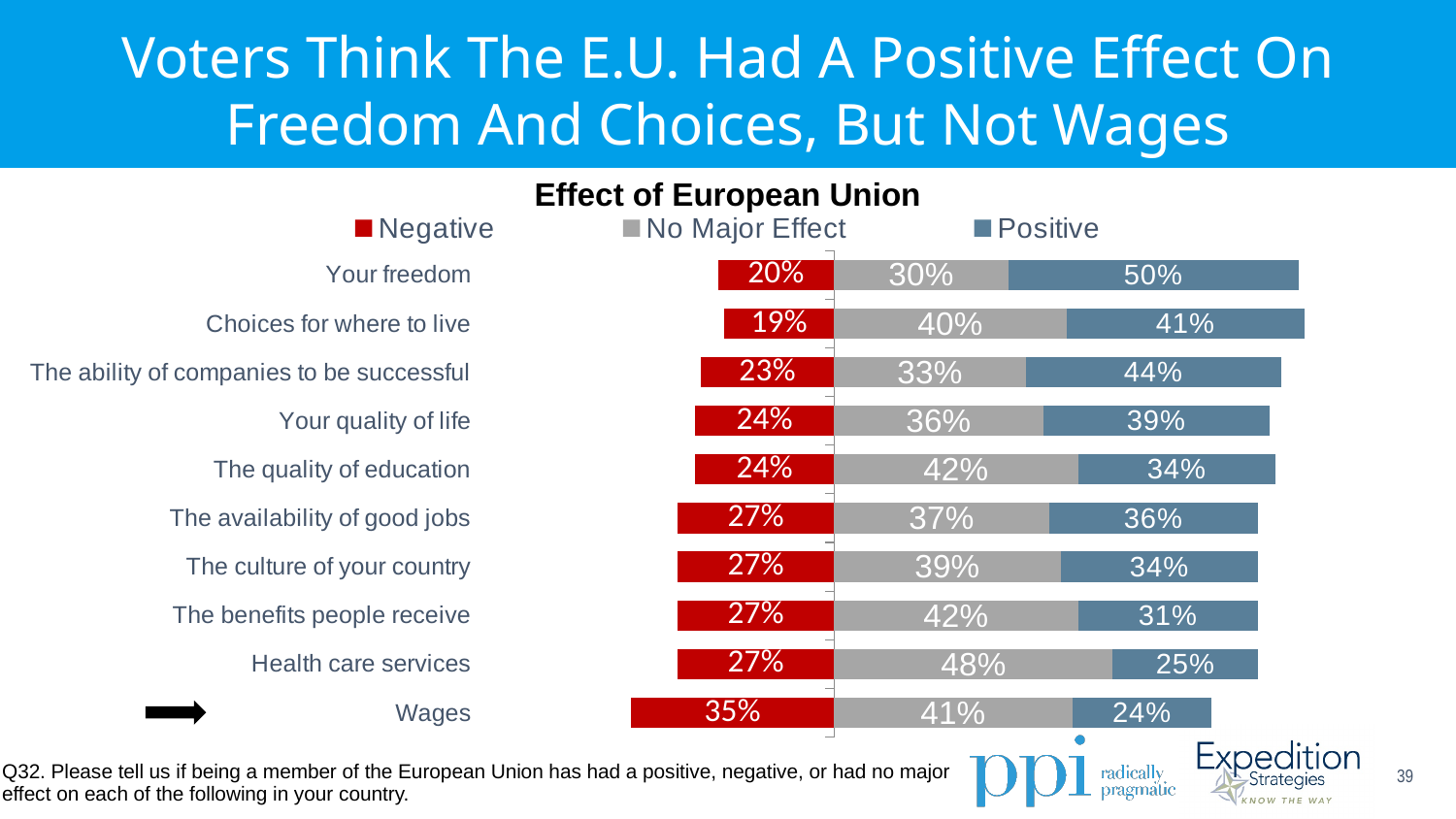
What kind of chart is shown on the slide? Stacked bar chart What is the difference between the Positive value for "Your freedom" and the Positive value for "Wages"? 26 percentage points How many categories are shown in the chart? 10 What is the total of the stacked bar for "Wages"? 100% Which category has the highest Positive value? Your freedom What percentage of voters said the E.U. had a positive effect on "Your freedom"? 50% Which category has the highest Negative value? Wages What is the No Major Effect value for "Health care services"? 48% Which category has the lowest Negative value? Choices for where to live What is the Negative value for "Wages"? 35% How many series does the legend list? 3 Which is larger: the Positive value for "The quality of education" or the Positive value for "Your quality of life"? Your quality of life